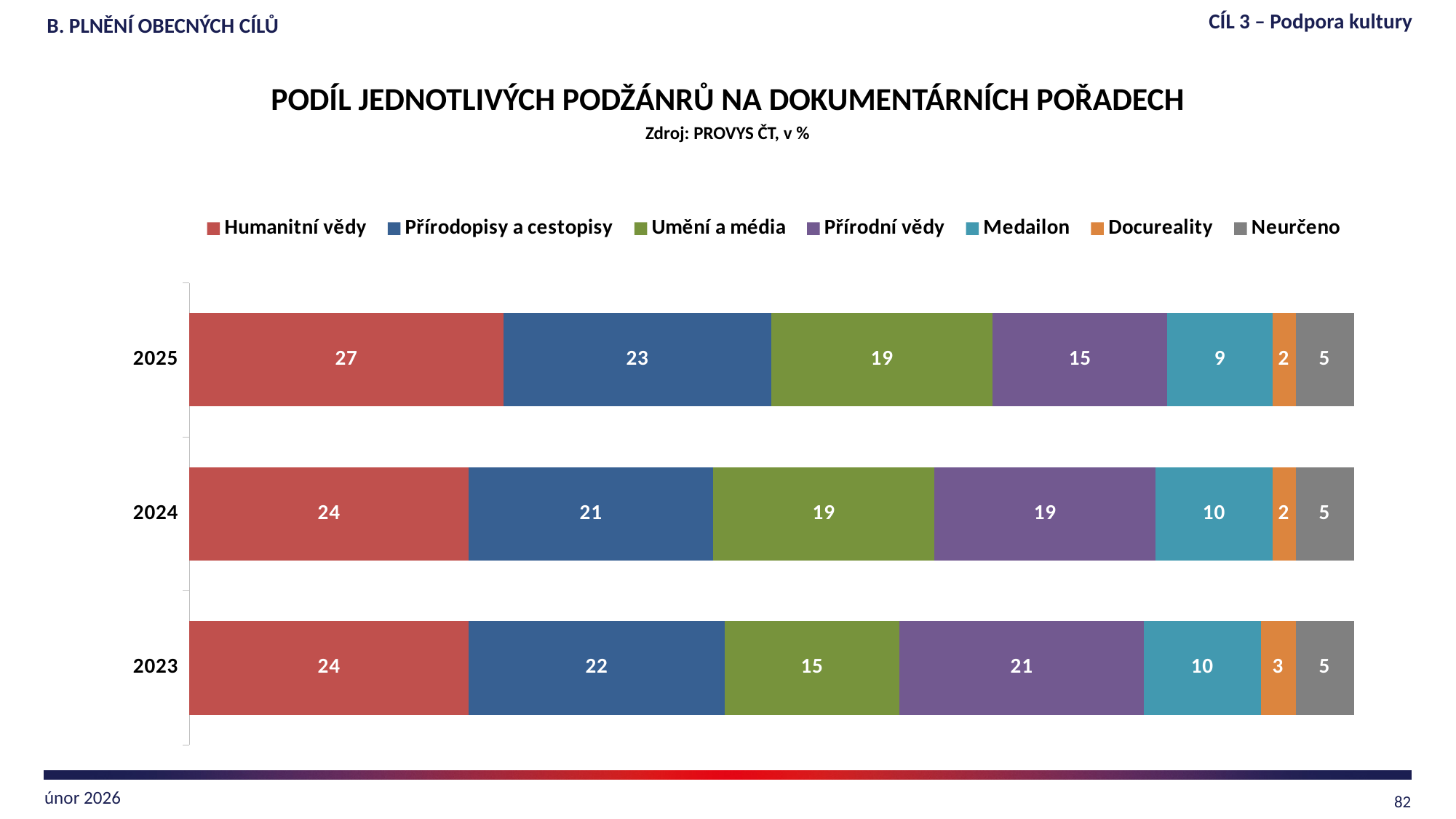
What is the value for Humanitní vědy in 2025? 27 How many series does the legend list? 7 What kind of chart is shown on the slide? Stacked bar chart Which subgenre has the highest share in 2025? Humanitní vědy Which subgenre has the lowest share in 2023? Docureality What is the value for Docureality in 2024? 2 How many years are shown on the chart? 3 Which is larger in 2023: Umění a média or Přírodní vědy? Přírodní vědy What is the total of the stacked bar for 2025? 100 What is the source stated under the chart title? PROVYS ČT, v % What is the value for Přírodní vědy in 2023? 21 What is the difference between Humanitní vědy and Přírodopisy a cestopisy in 2025? 4